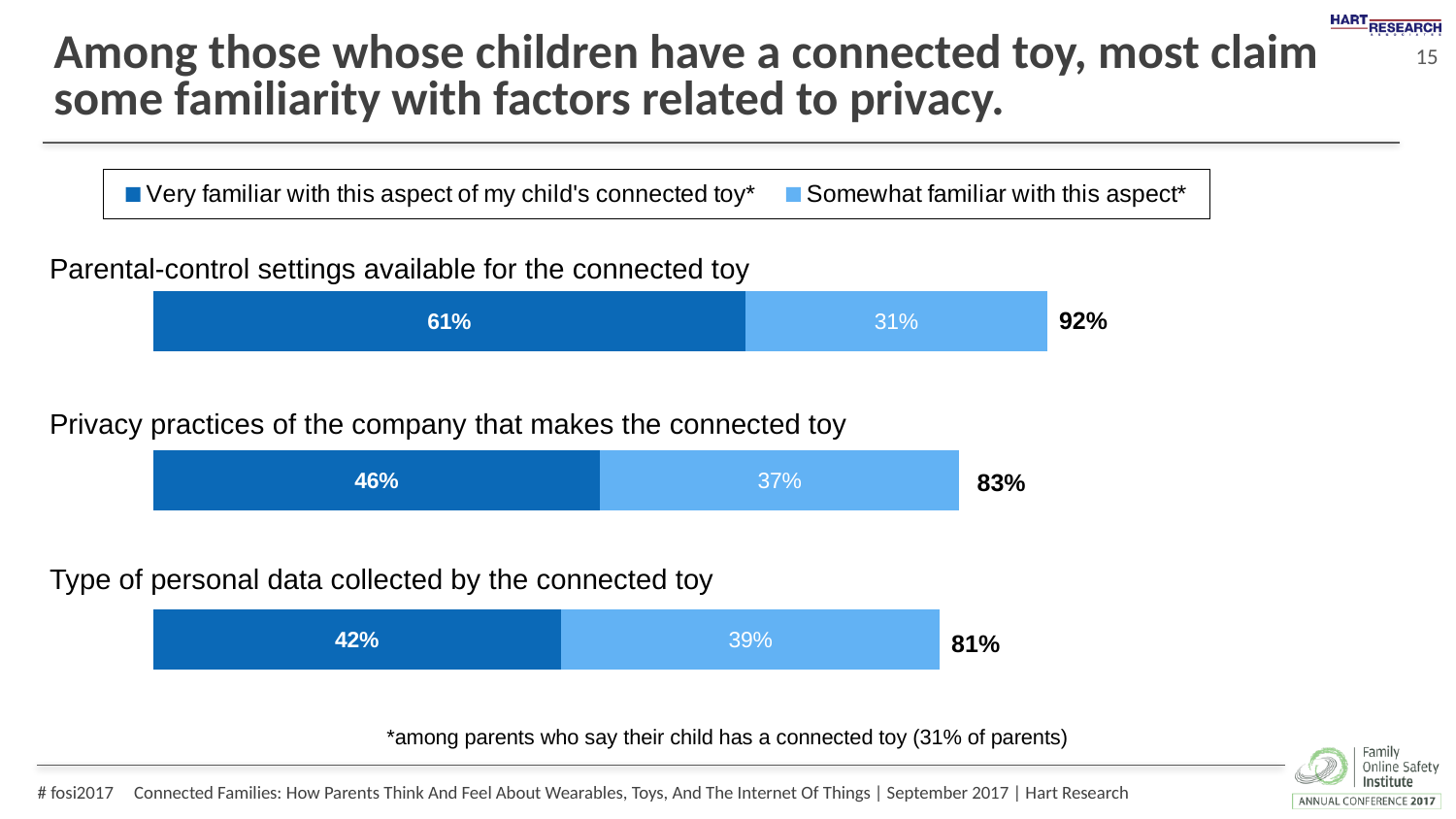
What kind of chart is shown on the slide? Stacked horizontal bar chart What is the combined total shown for 'Privacy practices of the company that makes the connected toy'? 83% According to the footnote, what percentage of parents say their child has a connected toy? 31% Which aspect has the highest share of parents who are very familiar with it? Parental-control settings available for the connected toy How many series does the legend list? 2 Is the 'somewhat familiar' share larger for the type of personal data collected or for the parental-control settings? Type of personal data collected by the connected toy What is the combined total shown for 'Type of personal data collected by the connected toy'? 81% What is the difference between the 'very familiar' percentages for parental-control settings and privacy practices of the company? 15 percentage points Which aspect has the lowest combined total of very and somewhat familiar? Type of personal data collected by the connected toy What percentage of parents are somewhat familiar with the privacy practices of the company that makes the connected toy? 37% How many aspects (categories) are shown in the chart? 3 What percentage of parents are very familiar with the parental-control settings available for the connected toy? 61%